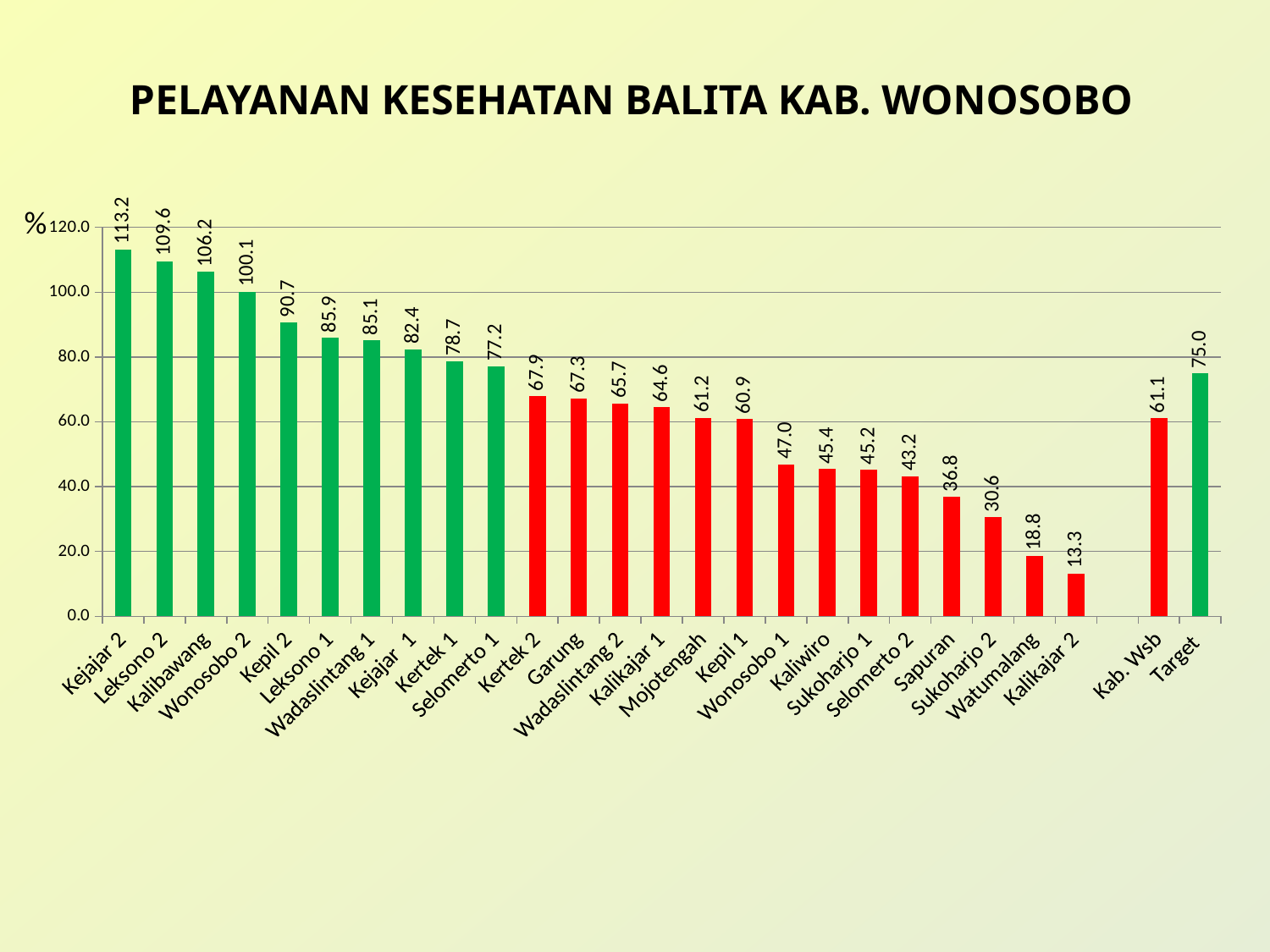
What is the value for Watumalang? 18.8 How many bars are plotted in the chart? 26 Which category has the highest value? Kejajar 2 What kind of chart is shown on the slide? Bar chart Which category has the lowest value? Kalikajar 2 What is the value for Kab. Wsb? 61.1 What is the difference between the Target value and the Kab. Wsb value? 13.9 What is the value shown for Target? 75.0 What is the value for Kejajar 2? 113.2 What is the difference between the values for Kejajar 2 and Kalikajar 2? 99.9 Which is larger, the value for Kepil 2 or the value for Kepil 1? Kepil 2 What is the title of the chart? PELAYANAN KESEHATAN BALITA KAB. WONOSOBO